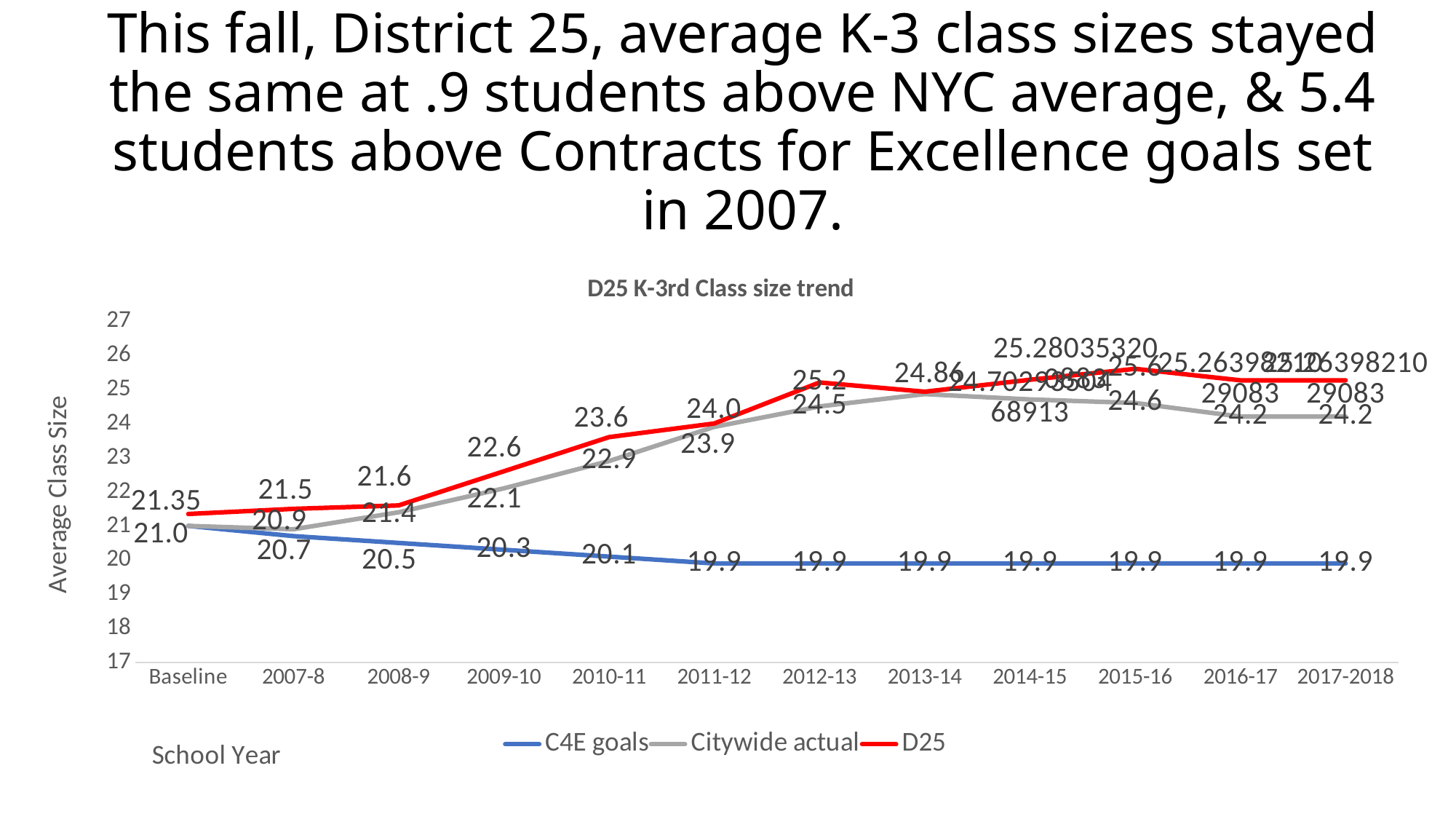
Do the C4E goals values rise or fall from Baseline to 2017-2018? fall What kind of chart is shown on the slide? line chart In 2009-10, which is larger: the D25 value or the Citywide actual value? D25 How many series does the legend list? 3 What is the C4E goals value for 2017-2018? 19.9 What is the difference between the D25 value and the Citywide actual value in 2012-13? 0.7 Is the Citywide actual value for 2013-14 greater or less than 24? greater What is the Citywide actual value for 2011-12? 23.9 How many school years (categories) are shown on the x axis? 12 What colour is the D25 line? red What is the D25 value for 2010-11? 23.6 What is the D25 value for 2012-13? 25.2